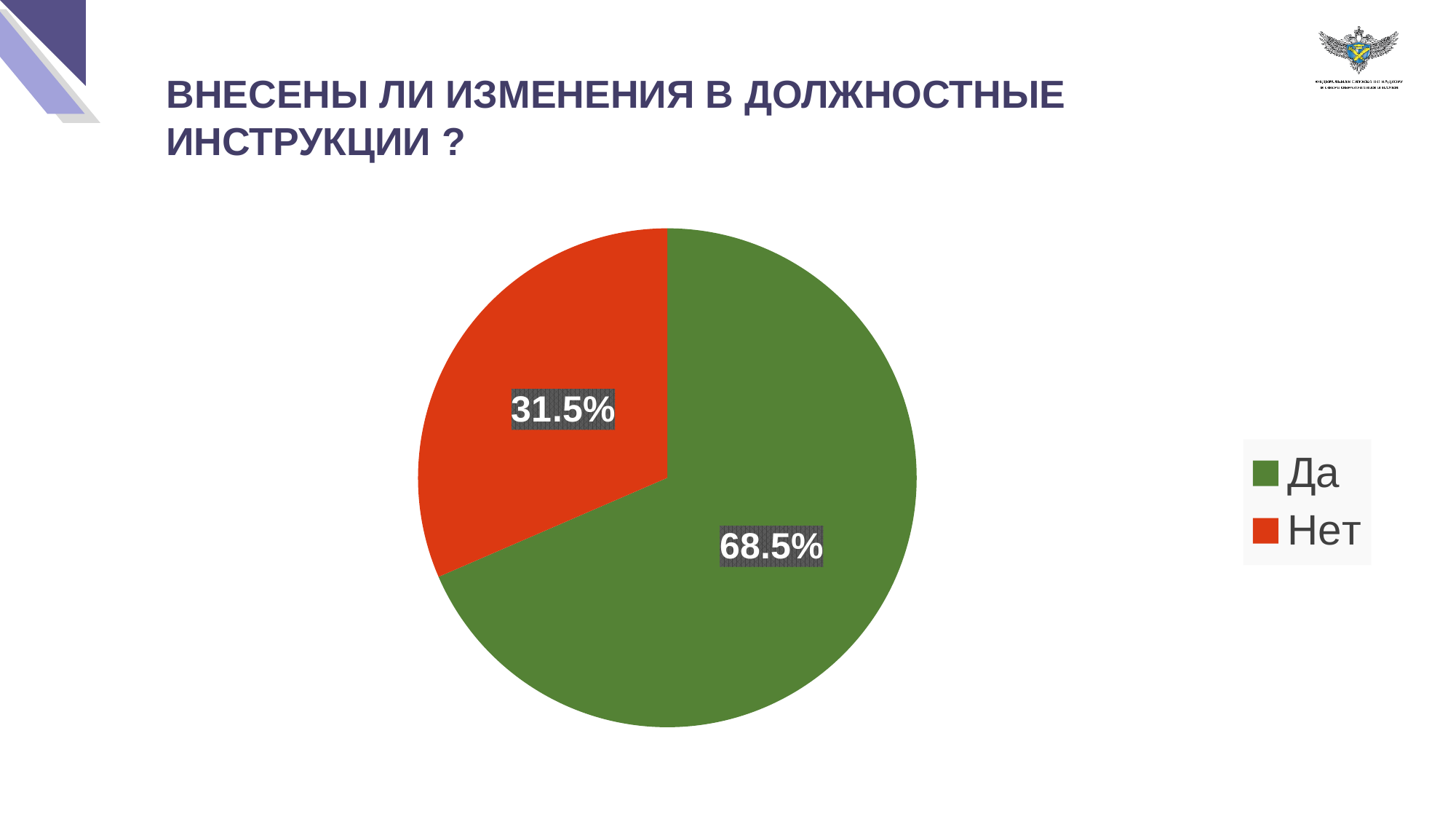
Which slice is the largest? Да What colour is the "Нет" slice? red Which is larger, "Да" or "Нет"? Да What is the value for "Нет"? 31.5% What is the difference between the "Да" and "Нет" slices? 37% How many entries does the legend list? 2 What colour is the "Да" slice? green What kind of chart is shown on the slide? pie chart Which slice is the smallest? Нет What is the value for "Да"? 68.5% What share of the pie does the "Нет" slice take? 31.5% How many slices does the pie chart have? 2